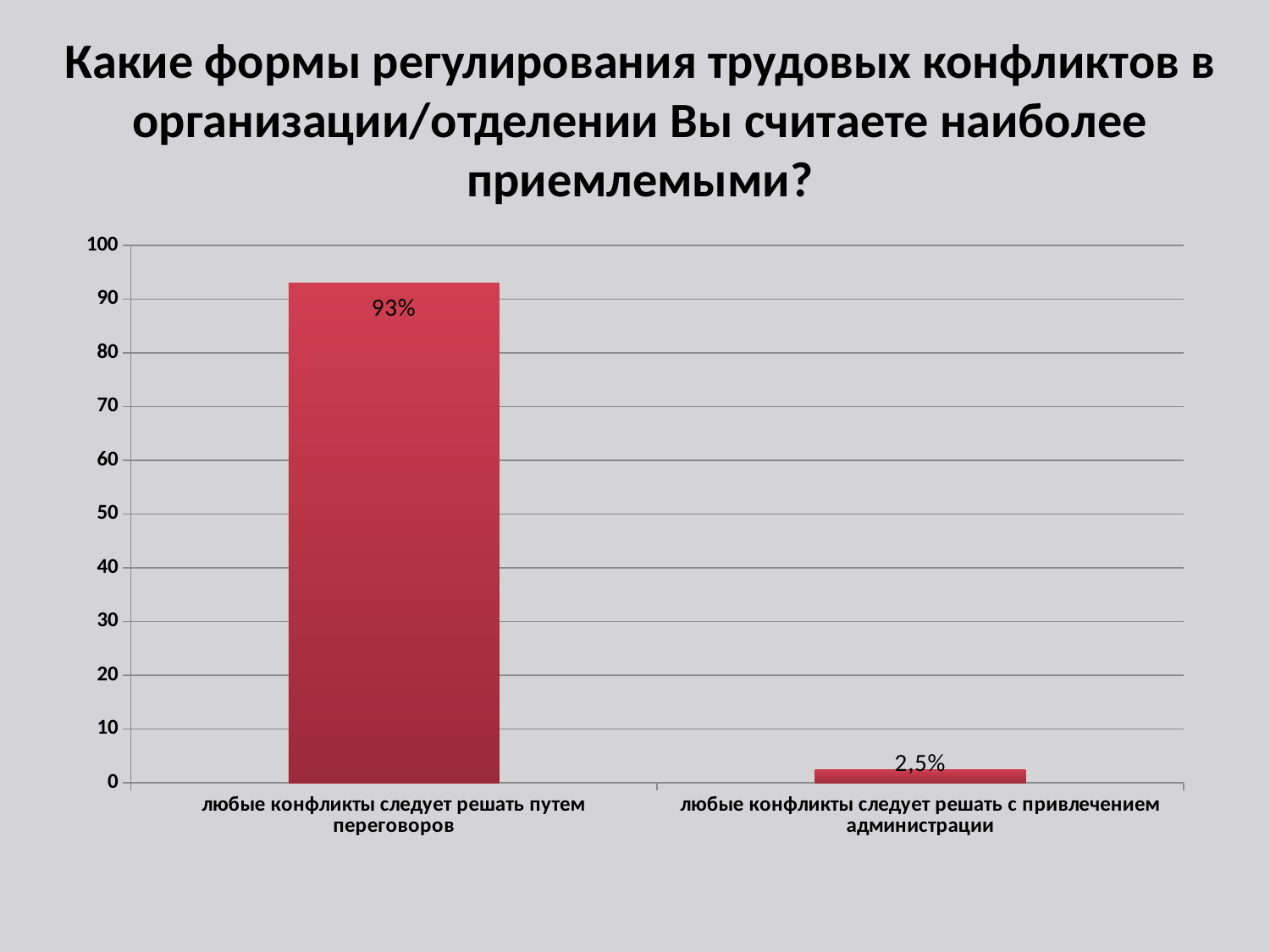
What colour are the bars on the chart? red Which is larger: the value for "любые конфликты следует решать путем переговоров" or for "любые конфликты следует решать с привлечением администрации"? любые конфликты следует решать путем переговоров What is the difference between the values for "любые конфликты следует решать путем переговоров" and "любые конфликты следует решать с привлечением администрации"? 90,5% What is the value for "любые конфликты следует решать с привлечением администрации"? 2,5% How many categories are shown on the chart? 2 What is the maximum value shown on the vertical axis? 100 Which category has the lowest value? любые конфликты следует решать с привлечением администрации Which category has the highest value? любые конфликты следует решать путем переговоров Is the value for "любые конфликты следует решать с привлечением администрации" greater or less than 10? less Is the value for "любые конфликты следует решать путем переговоров" greater or less than 90? greater What kind of chart is shown on the slide? bar chart What is the value for "любые конфликты следует решать путем переговоров"? 93%